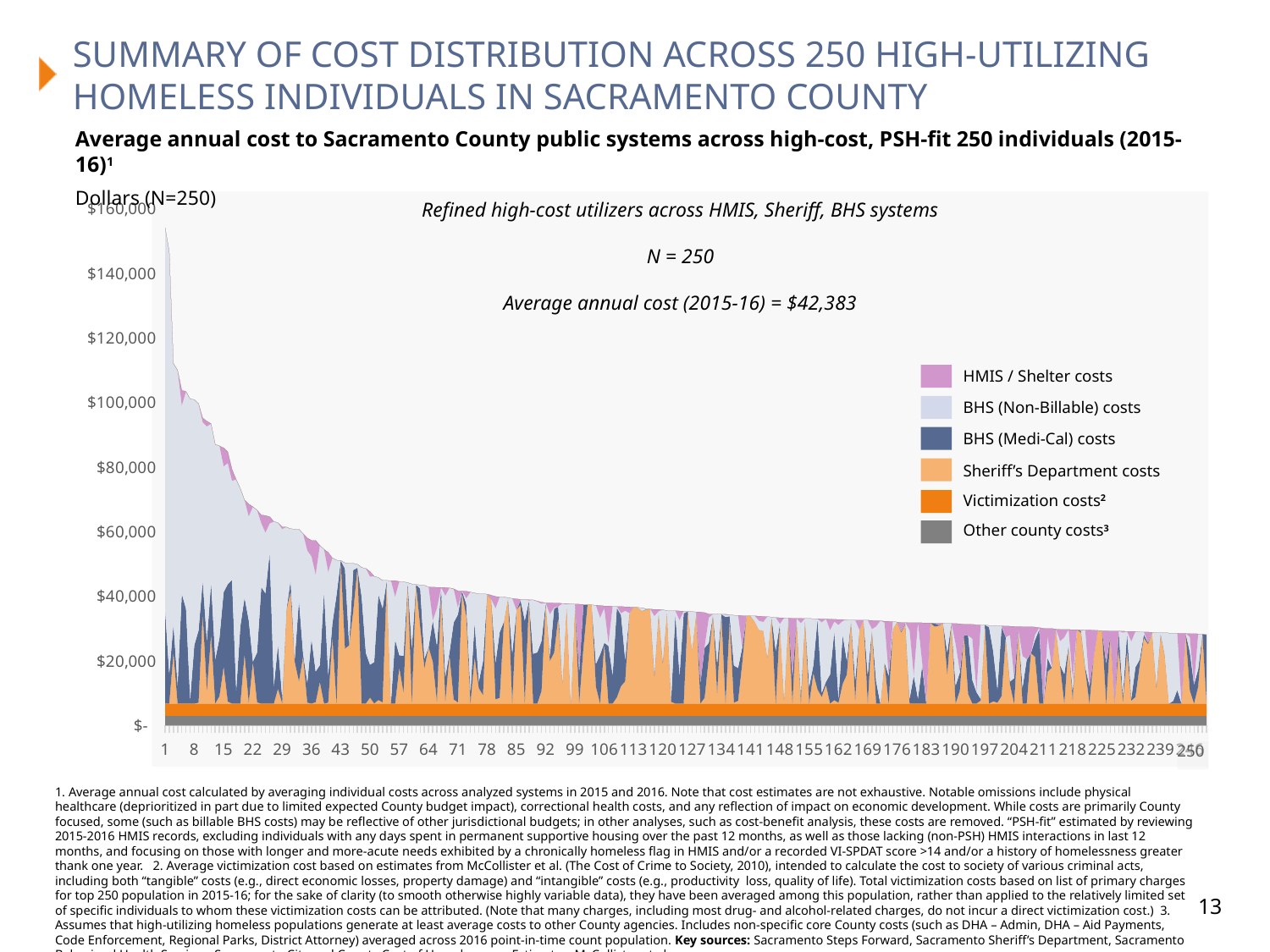
What kind of chart is shown on the slide? Stacked area chart Do the total annual costs rise or fall as you move from individual 1 to individual 250 along the x axis? Fall Is the total annual cost for individual 1 greater or less than $140,000? greater What is the highest value shown on the y axis of the chart? $160,000 Is the total annual cost for individual 50 greater or less than $60,000? less Which has a larger total annual cost, individual 8 or individual 120? Individual 8 How many series does the chart legend list? 6 How many individuals are plotted along the x axis of the chart? 250 Which legend entry is shown in pink/magenta? HMIS / Shelter costs What is the average annual cost (2015-16) stated on the chart? $42,383 Which individual on the x axis has the highest total annual cost? 1 Is the total annual cost for individual 250 greater or less than $40,000? less